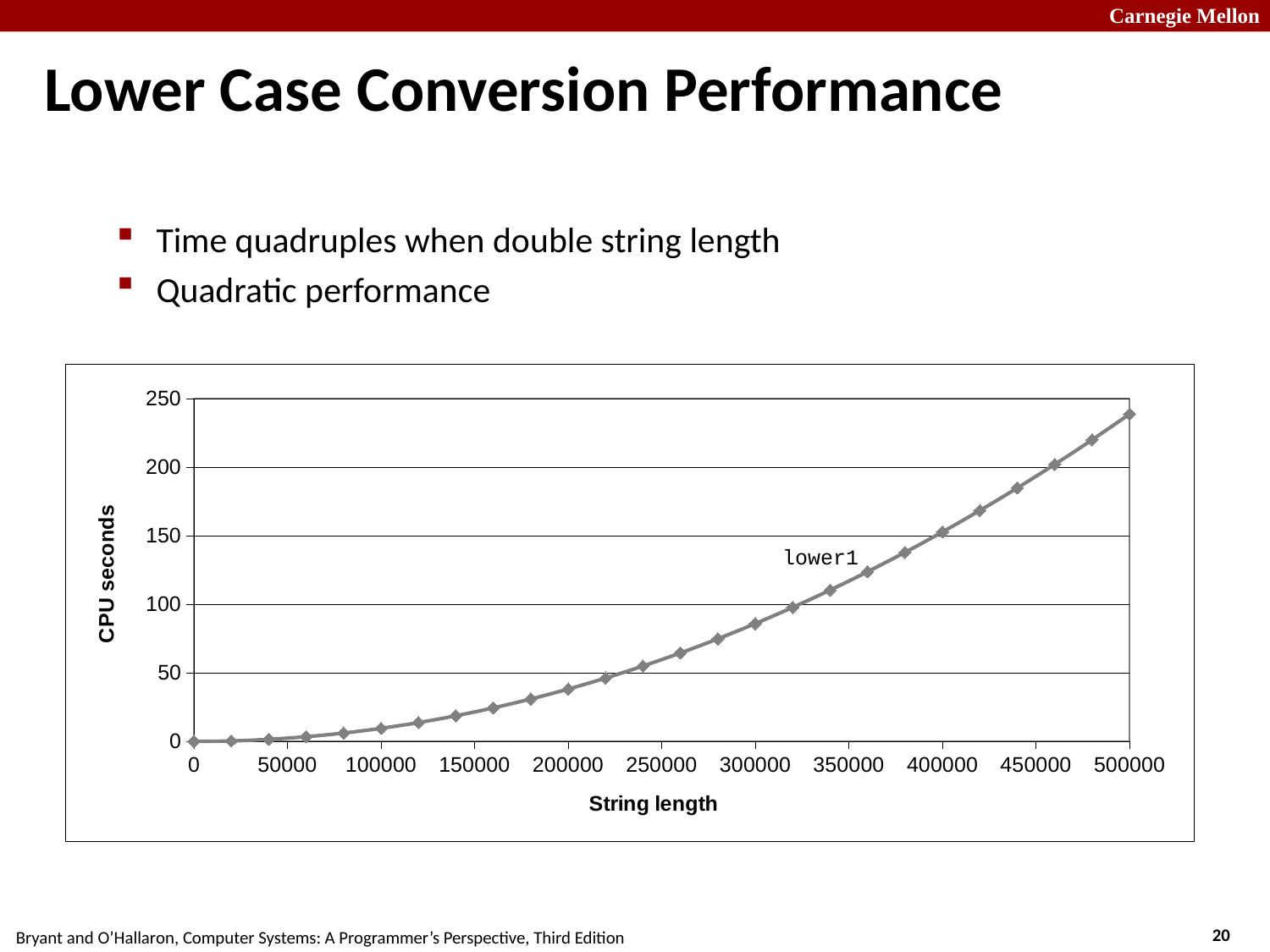
What kind of chart is shown on the slide? line chart Is the CPU seconds value at string length 300000 greater or less than 100? less What is the name of the series plotted in the chart? lower1 Is the CPU seconds value at string length 200000 greater or less than 50? less Which has the larger CPU time, string length 100000 or string length 400000? 400000 Do the CPU seconds rise or fall as string length increases? rise At which string length is the CPU time highest? 500000 How many series does the chart plot? 1 What is the label of the y axis? CPU seconds At which string length is the CPU time lowest? 0 Is the CPU seconds value at string length 400000 greater or less than 100? greater